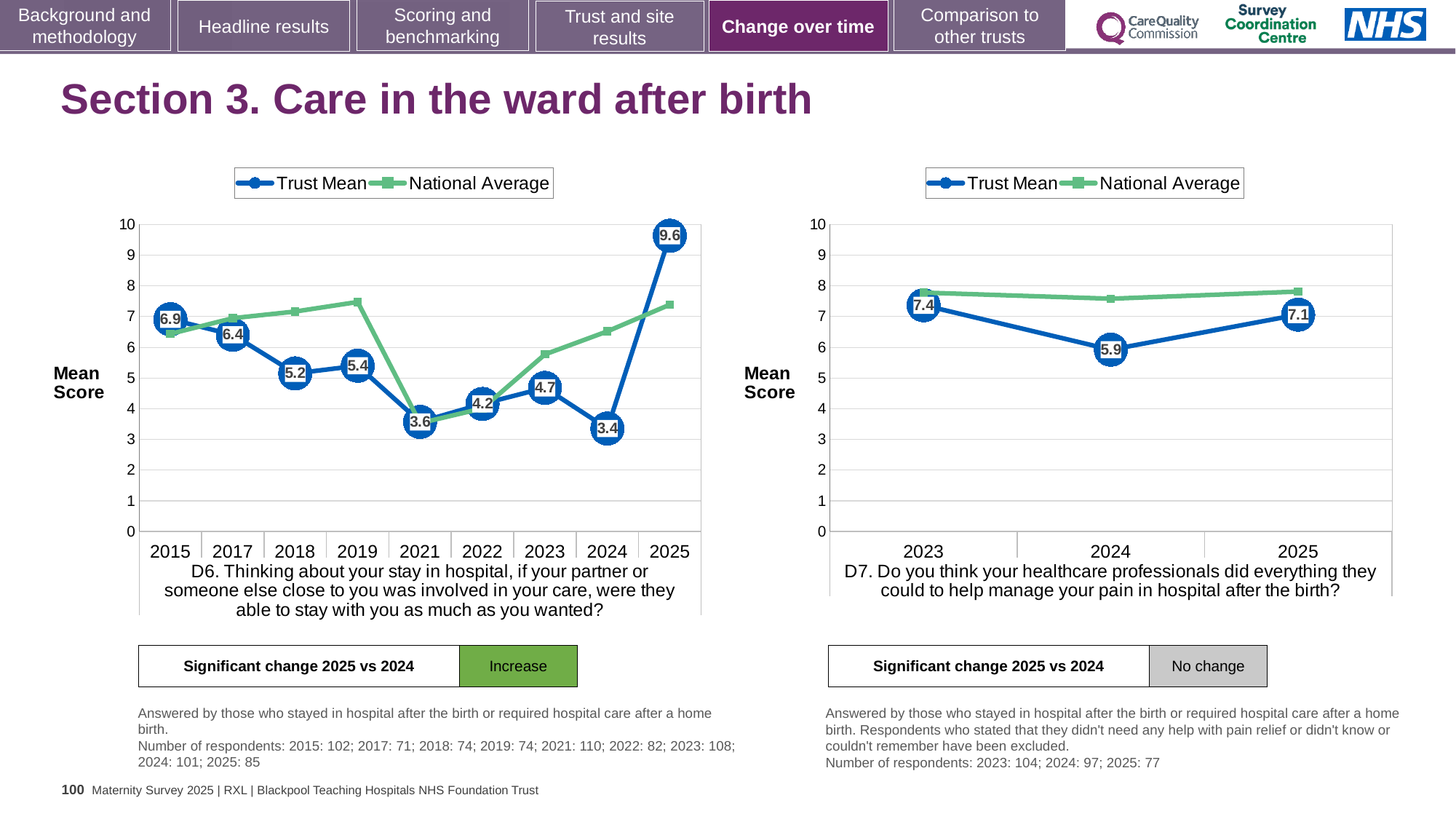
In the left chart (D6), which year has the highest Trust Mean score? 2025 In the left chart (D6), what is the Trust Mean score for 2025? 9.6 What kind of chart is the right chart (D7)? Line chart In the right chart (D7), is the National Average for 2024 greater or less than 7? greater In the left chart (D6), what is the Trust Mean score for 2021? 3.6 In the left chart (D6), how many years are shown on the x axis? 9 In the right chart (D7), what is the Trust Mean score for 2024? 5.9 How many series does the legend of the right chart (D7) list? 2 In the left chart (D6), which year has the lowest Trust Mean score? 2024 In the left chart (D6), is the National Average for 2019 greater or less than 7? greater In the left chart (D6), what is the difference between the Trust Mean scores for 2025 and 2024? 6.2 In the right chart (D7), which is larger, the Trust Mean for 2023 or for 2025? 2023